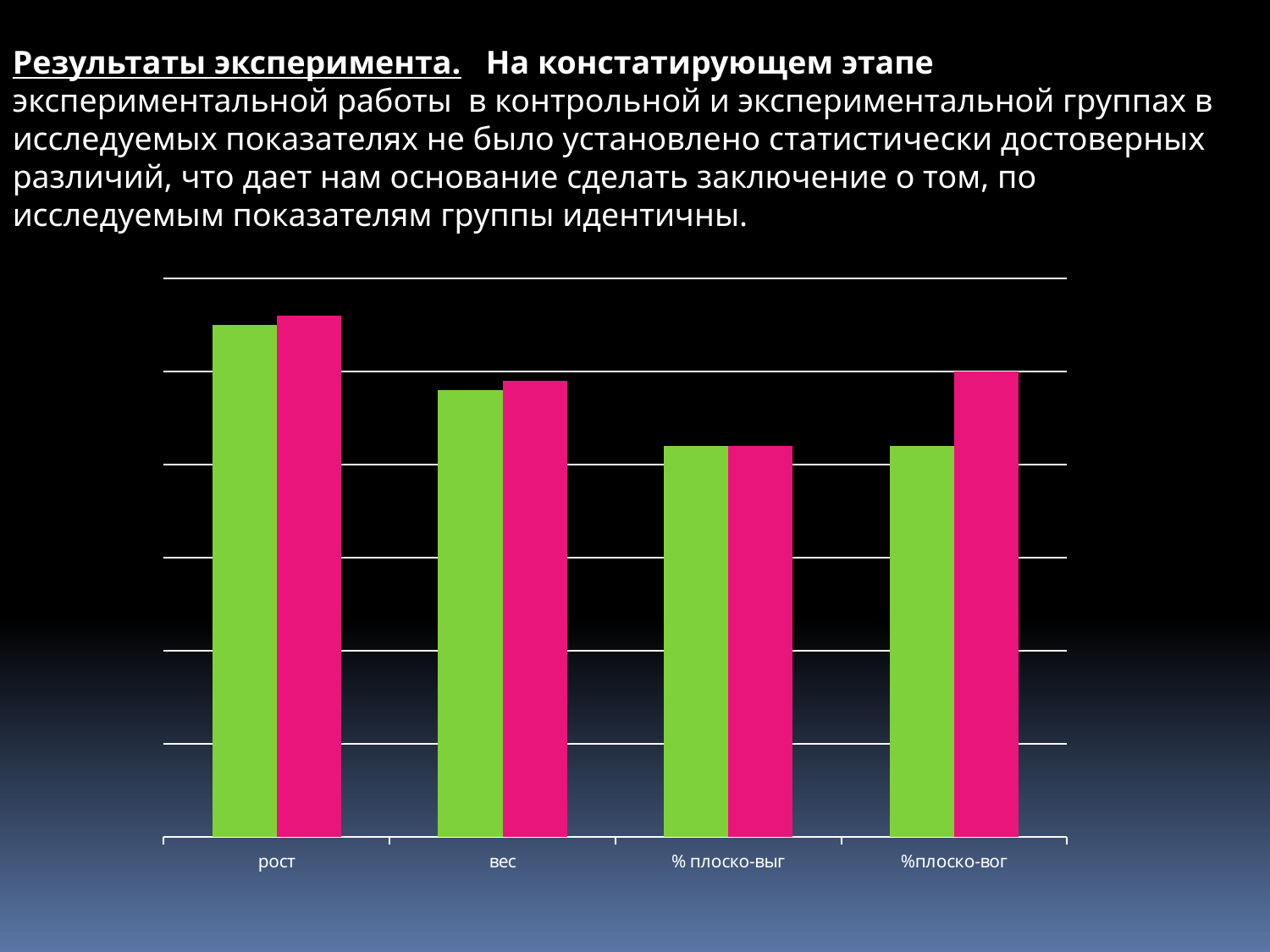
What is the label of the first category on the x axis? рост For the pink bars, which is larger, вес or %плоско-вог? %плоско-вог For the green bars, which is larger, рост or вес? рост In the category рост, which bar is taller, the green one or the pink one? pink How many categories are shown on the x axis of the chart? 4 What kind of chart is shown on the slide? bar chart Which category has the tallest bars in the chart? рост What two colours are used for the bars in the chart? green and pink For the pink bars, which category has the lowest value? % плоско-выг